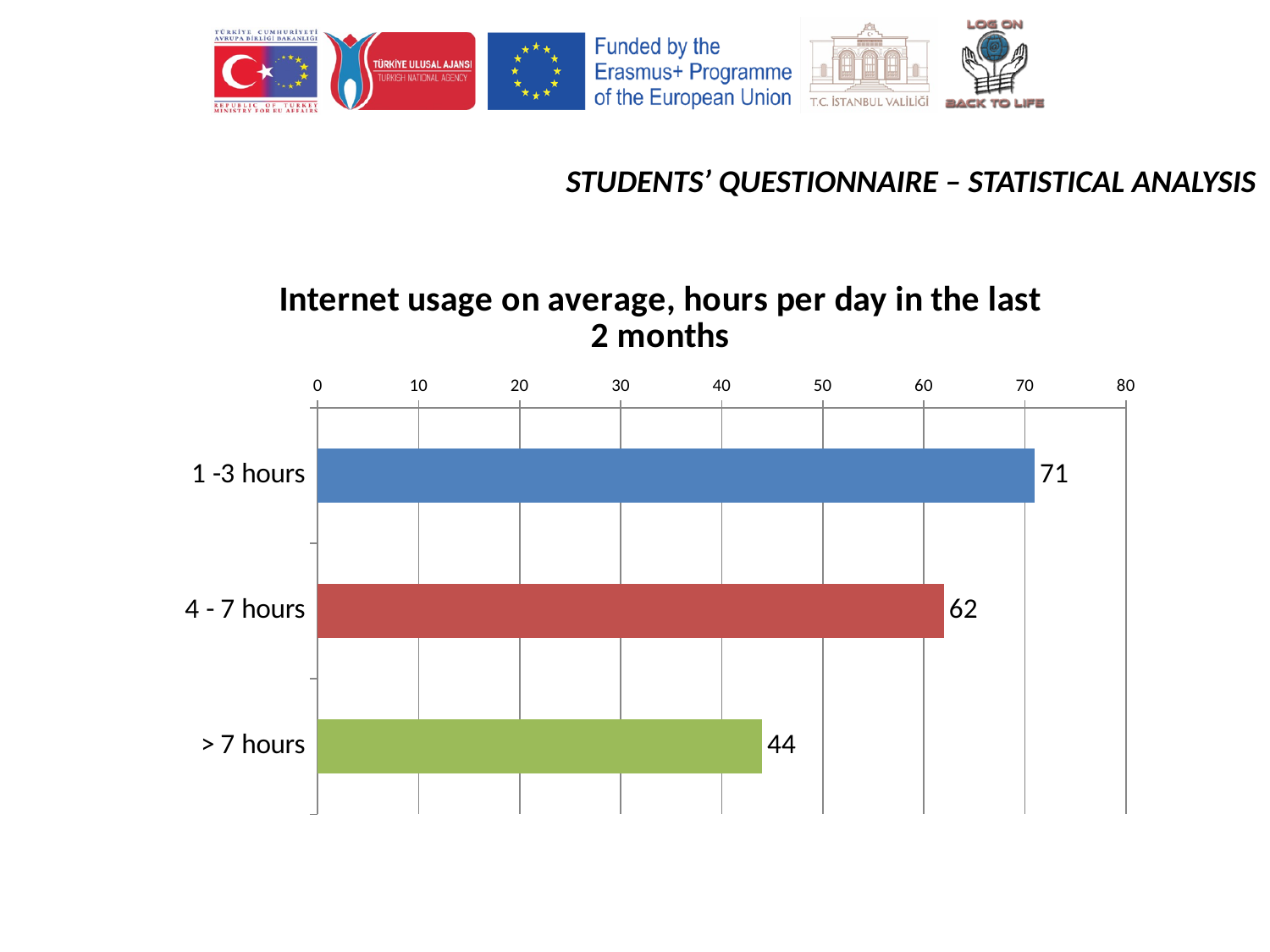
What is the value for the '4 - 7 hours' category? 62 Is the value for '> 7 hours' greater or less than 50? less What is the difference between the values for '1 -3 hours' and '> 7 hours'? 27 What is the title of the chart? Internet usage on average, hours per day in the last 2 months What is the difference between the values for '1 -3 hours' and '4 - 7 hours'? 9 Which category has the highest value? 1 -3 hours What kind of chart is shown on the slide? bar chart Which category has the lowest value? > 7 hours Which is larger, the value for '4 - 7 hours' or the value for '> 7 hours'? 4 - 7 hours What is the value for the '1 -3 hours' category? 71 What is the value for the '> 7 hours' category? 44 How many categories are shown in the chart? 3